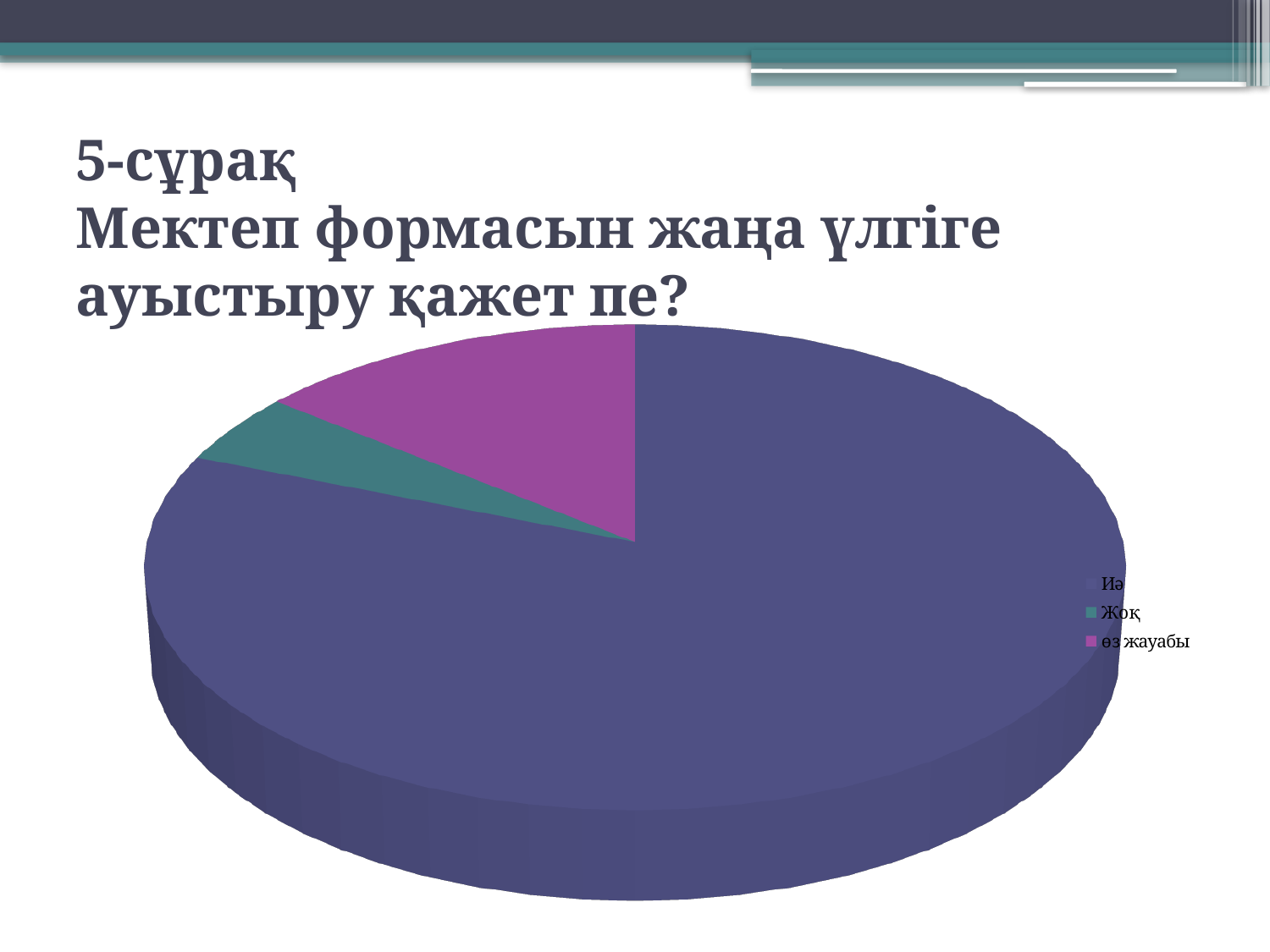
What colour is the slice for Жоқ? teal What are the three legend entries of the pie chart? Иә, Жоқ, өз жауабы Which category has the smallest slice of the pie? Жоқ Which slice is larger, Жоқ or өз жауабы? өз жауабы How many slices does the pie chart have? 3 How many entries does the legend list? 3 Which slice is smaller, Иә or Жоқ? Жоқ Which slice is larger, Иә or өз жауабы? Иә Which category has the largest slice of the pie? Иә What kind of chart is shown on the slide? pie chart